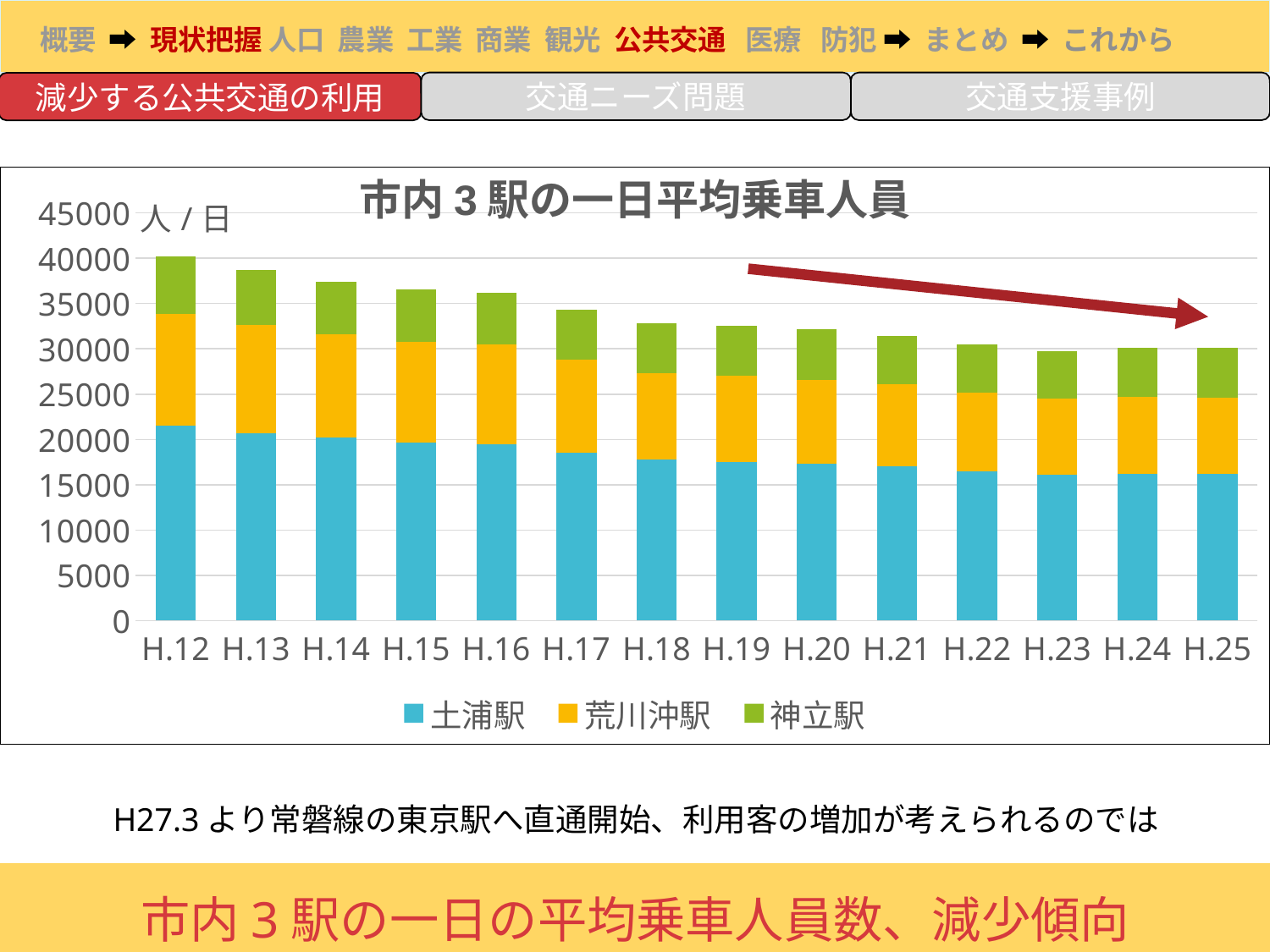
What is the title of the chart? 市内3駅の一日平均乗車人員 Is the value for 土浦駅 in H.12 greater or less than 20000? greater How many series does the chart legend list? 3 How many years (categories) are shown on the x axis of the chart? 14 What kind of chart is shown on the slide? stacked bar chart Do the total daily passenger numbers rise or fall from H.12 to H.25? fall Which station is listed first in the chart legend? 土浦駅 Is the value for 土浦駅 in H.25 greater or less than 20000? less Which is larger, the total stacked bar for H.12 or for H.25? H.12 Is the total stacked value for H.25 greater or less than 35000? less Which year has the highest total stacked bar? H.12